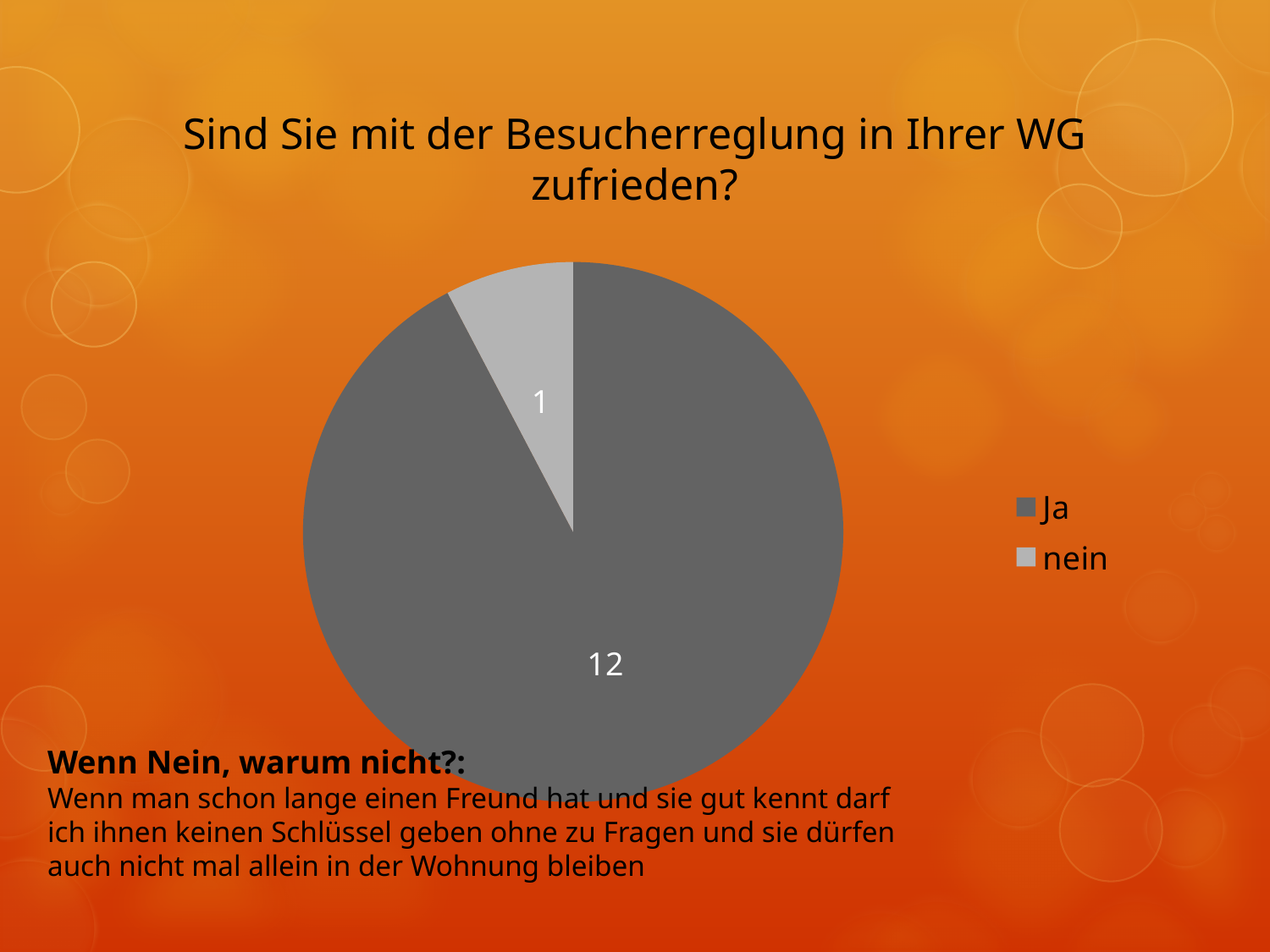
Which category has the largest slice? Ja Which legend entry is shown in the lighter grey colour? nein What is the value for "nein"? 1 What is the difference between the values for "Ja" and "nein"? 11 Which category has the smallest slice? nein What kind of chart is shown on the slide? pie chart How many categories does the pie chart have? 2 What is the total of all slices in the pie chart? 13 What is the title of the chart? Sind Sie mit der Besucherreglung in Ihrer WG zufrieden? How many entries does the legend list? 2 What is the value for "Ja"? 12 Which is larger, the value for "Ja" or the value for "nein"? Ja